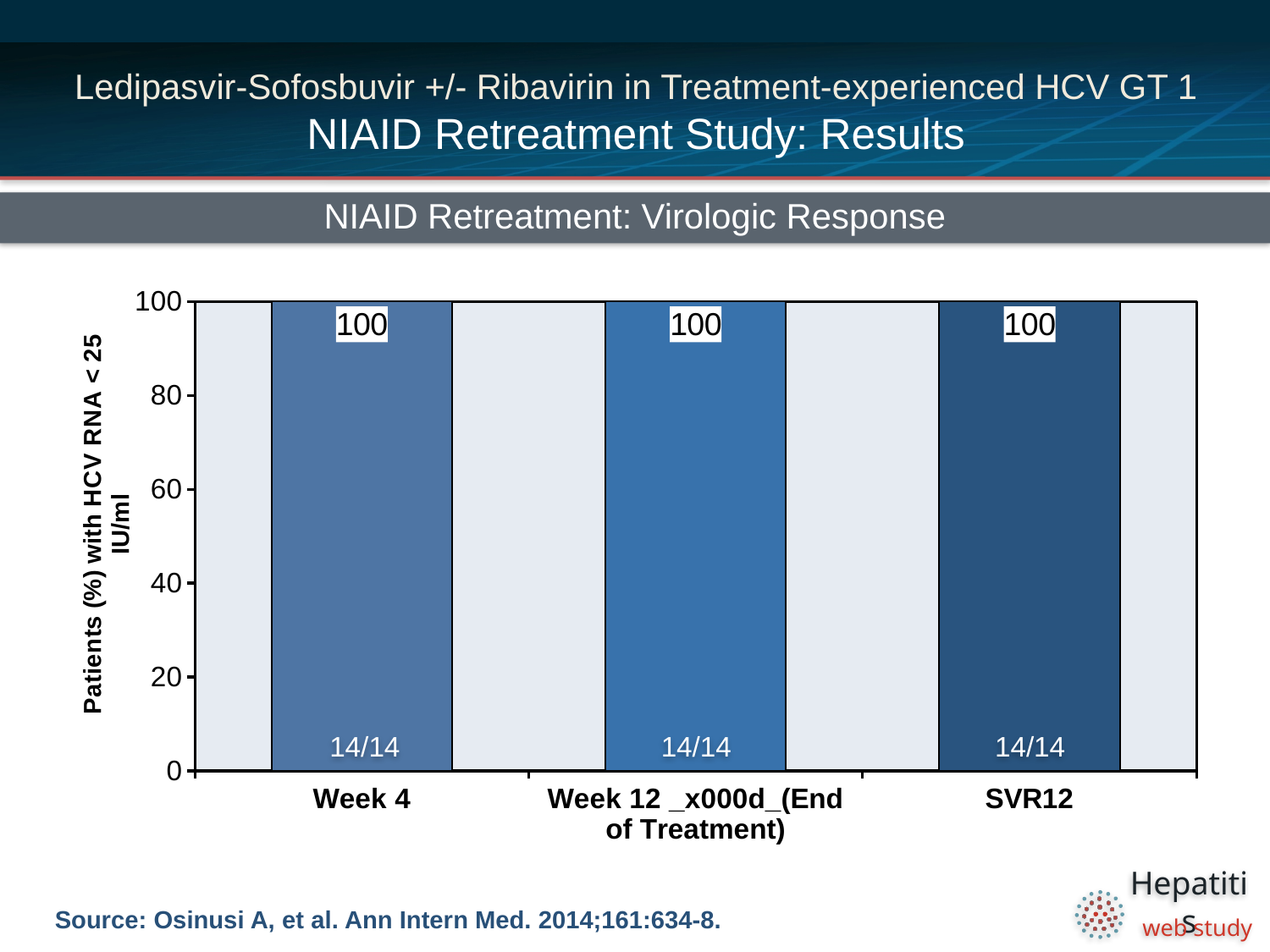
What fraction of patients is shown inside the SVR12 bar? 14/14 What is the y-axis label of the chart? Patients (%) with HCV RNA < 25 IU/ml How many categories are shown on the x axis? 3 What is the value for Week 4? 100 What is the title of the chart? NIAID Retreatment: Virologic Response Is the value for Week 4 greater or less than 80? greater What kind of chart is shown on the slide? bar chart What is the value for Week 12 (End of Treatment)? 100 What is the difference between the values for Week 4 and SVR12? 0 Do the values rise, fall, or stay the same from Week 4 to SVR12? stay the same What fraction of patients is shown inside the Week 4 bar? 14/14 What is the value for SVR12? 100